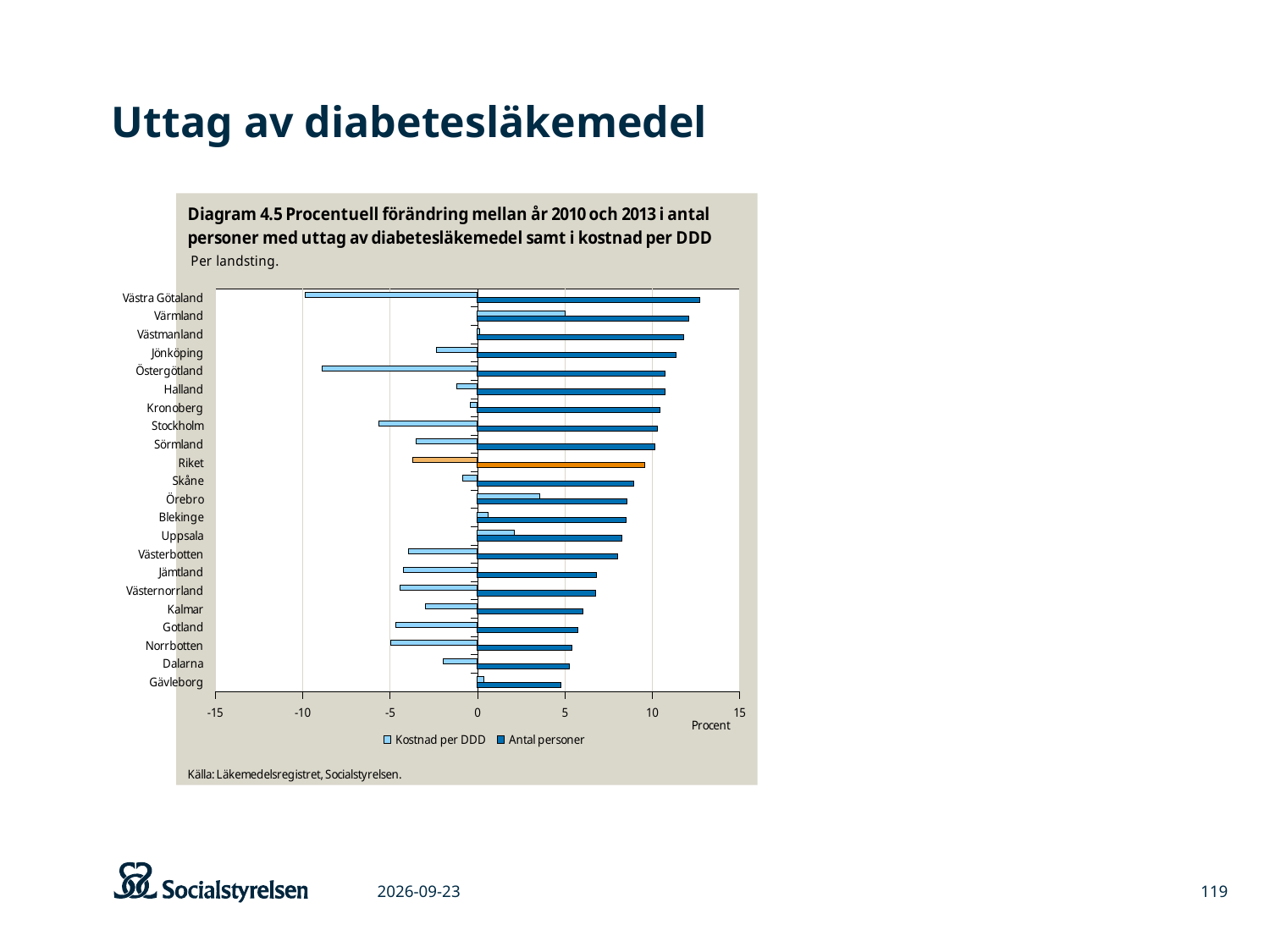
Which category's bars are drawn in orange instead of blue? Riket Is the Antal personer value for Västra Götaland greater or less than 10? greater What are the two series named in the legend? Kostnad per DDD and Antal personer What kind of chart is shown on the slide? bar chart Do the Antal personer values rise or fall going from the top category to the bottom category? fall How many landsting/categories are listed on the vertical axis? 22 How many series does the legend list? 2 Which is larger: the Antal personer value for Västra Götaland or for Gävleborg? Västra Götaland Is the Kostnad per DDD value for Östergötland greater or less than -5? less Which category has the highest value for Kostnad per DDD? Värmland Is the Antal personer value for Kalmar greater or less than 5? greater Which category has the highest value for Antal personer? Västra Götaland